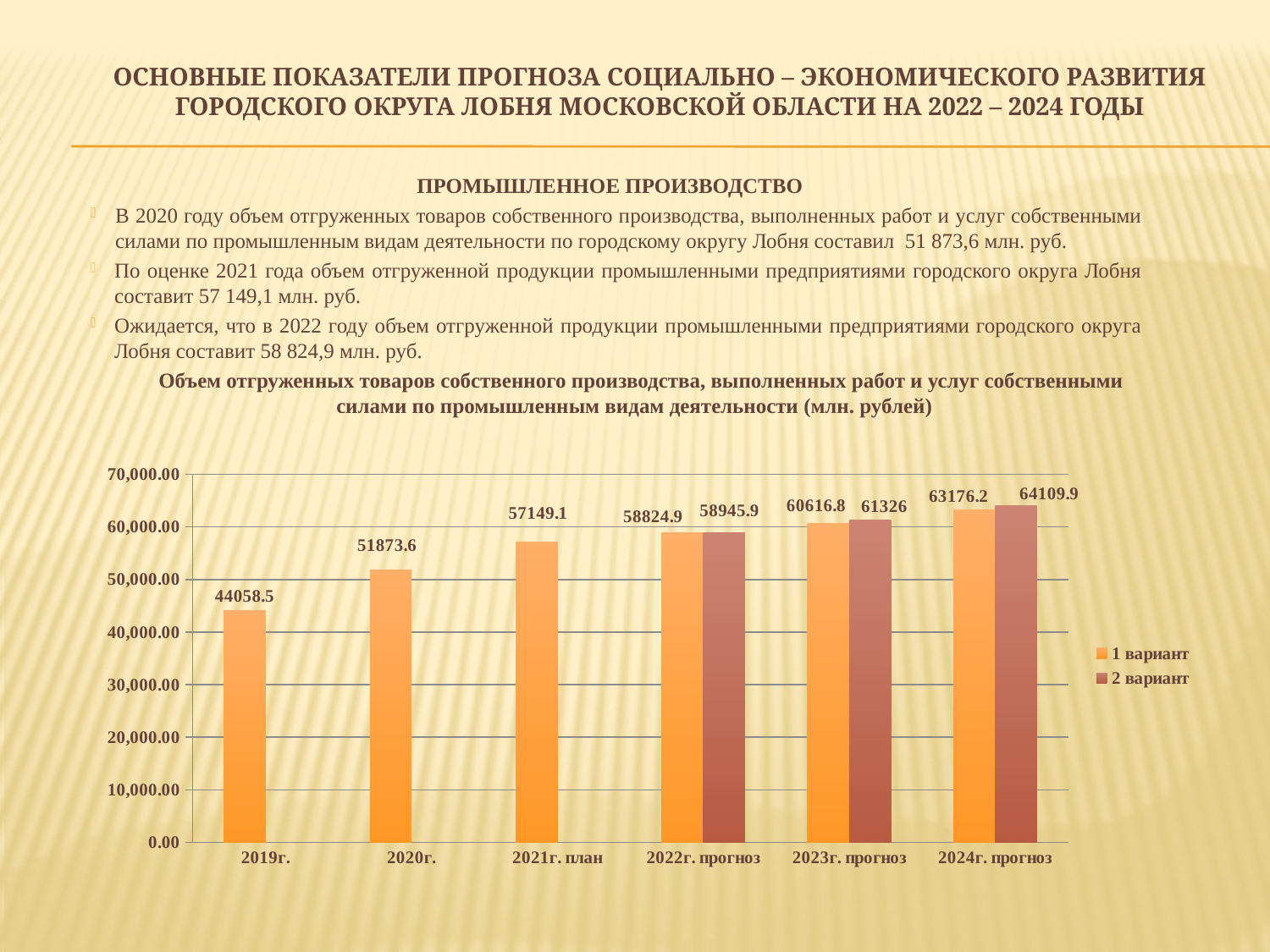
Which is larger in 2022г. прогноз: 1 вариант or 2 вариант? 2 вариант Which category has the highest value for 2 вариант? 2024г. прогноз Which category has the lowest value for 1 вариант? 2019г. What kind of chart is shown on the slide? bar chart What is the value for 1 вариант in 2019г.? 44058.5 Do the values for 1 вариант rise or fall from 2019г. to 2024г. прогноз? rise What is the value for 1 вариант in 2021г. план? 57149.1 How many categories are shown on the x axis? 6 What is the difference between the 2 вариант and 1 вариант values in 2024г. прогноз? 933.7 What is the value for 2 вариант in 2023г. прогноз? 61326 Is the value for 1 вариант in 2020г. greater or less than 50,000.00? greater How many series does the legend list? 2